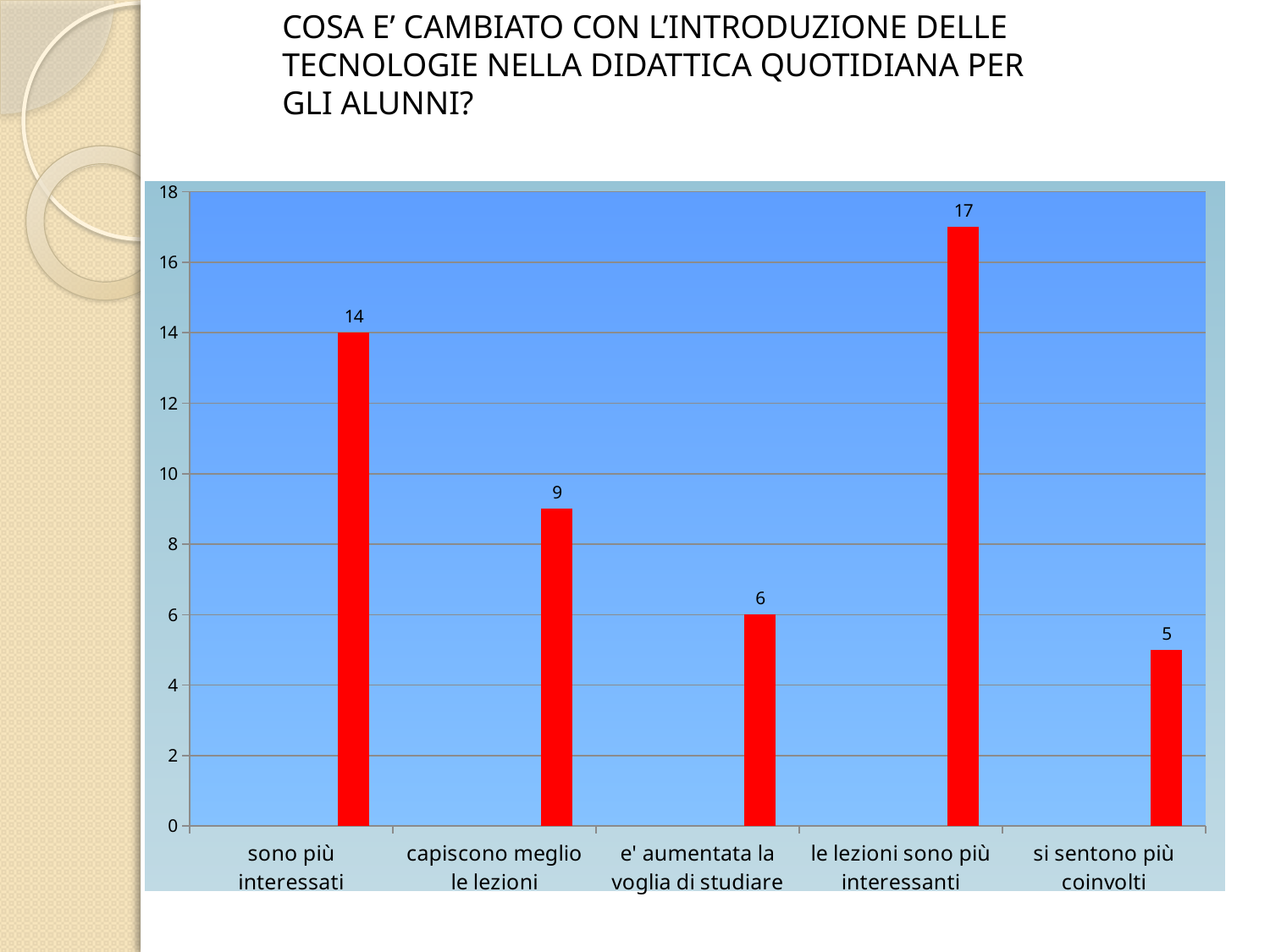
What is the difference between the values for 'capiscono meglio le lezioni' and 'e' aumentata la voglia di studiare'? 3 Which is larger, the value for 'e' aumentata la voglia di studiare' or the value for 'si sentono più coinvolti'? e' aumentata la voglia di studiare Is the value for 'sono più interessati' greater or less than 10? greater What kind of chart is shown on the slide? bar chart What is the value for 'capiscono meglio le lezioni'? 9 Which category has the lowest value? si sentono più coinvolti What is the value for 'si sentono più coinvolti'? 5 What colour are the bars in the chart? red How many categories are shown on the x axis? 5 What is the value for 'sono più interessati'? 14 Which category has the highest value? le lezioni sono più interessanti What is the difference between the values for 'le lezioni sono più interessanti' and 'sono più interessati'? 3